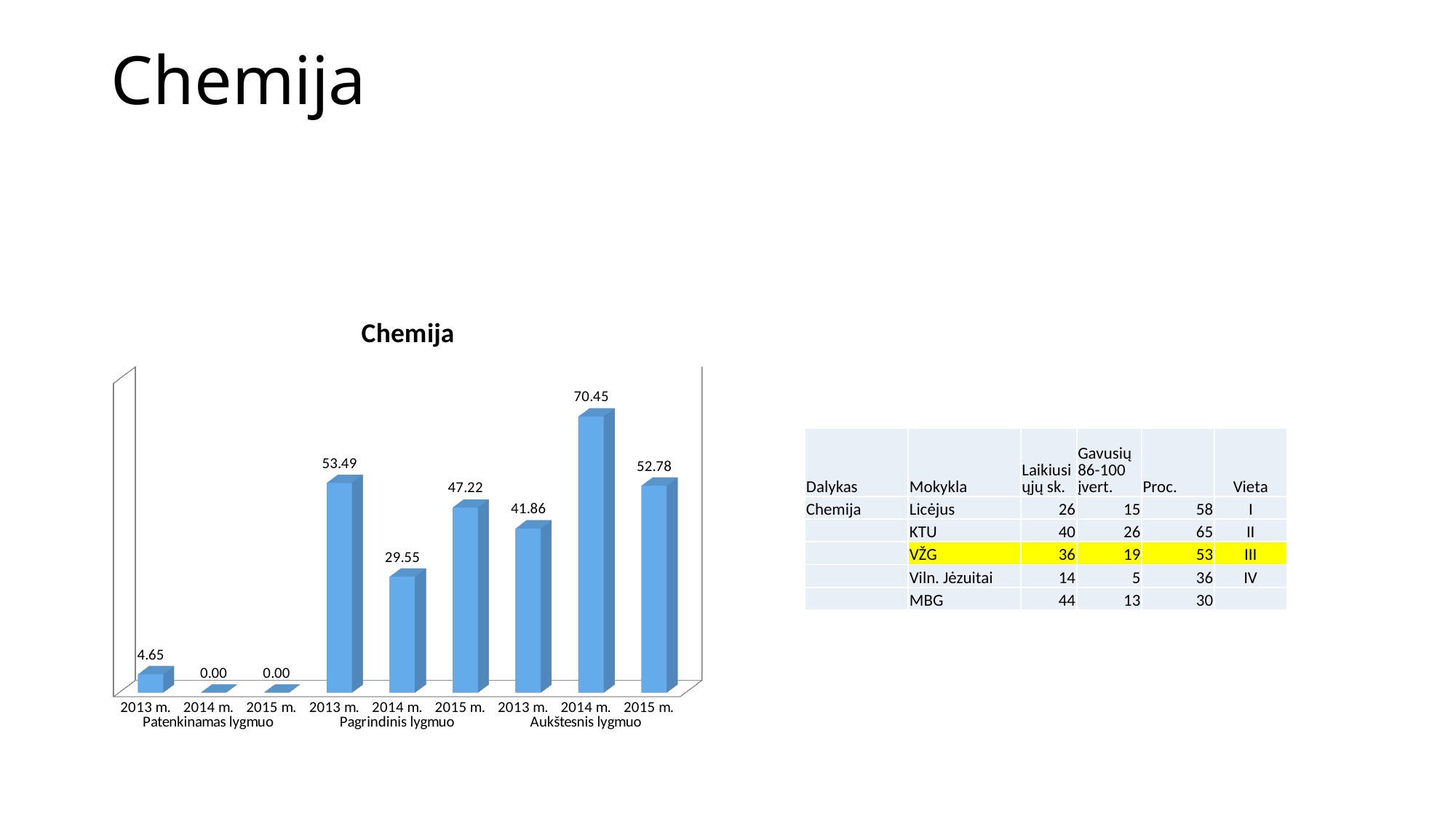
What is the difference between the 2013 m. and 2014 m. values in the Pagrindinis lygmuo group? 23.94 What is the value for 2014 m. in the Patenkinamas lygmuo group? 0.00 What is the difference between the 2014 m. and 2015 m. values in the Aukštesnis lygmuo group? 17.67 What type of chart is shown on the slide? bar chart What is the value for 2014 m. in the Pagrindinis lygmuo group? 29.55 What is the title of the chart? Chemija How many level groups are shown on the x axis of the chart? 3 How many bars are plotted in the chart? 9 What is the value for 2015 m. in the Aukštesnis lygmuo group? 52.78 Which bar has the highest value in the chart? 2014 m. Aukštesnis lygmuo (70.45) What is the value for 2013 m. in the Patenkinamas lygmuo group? 4.65 Which is larger: the 2013 m. value for Pagrindinis lygmuo or the 2013 m. value for Aukštesnis lygmuo? Pagrindinis lygmuo (53.49)